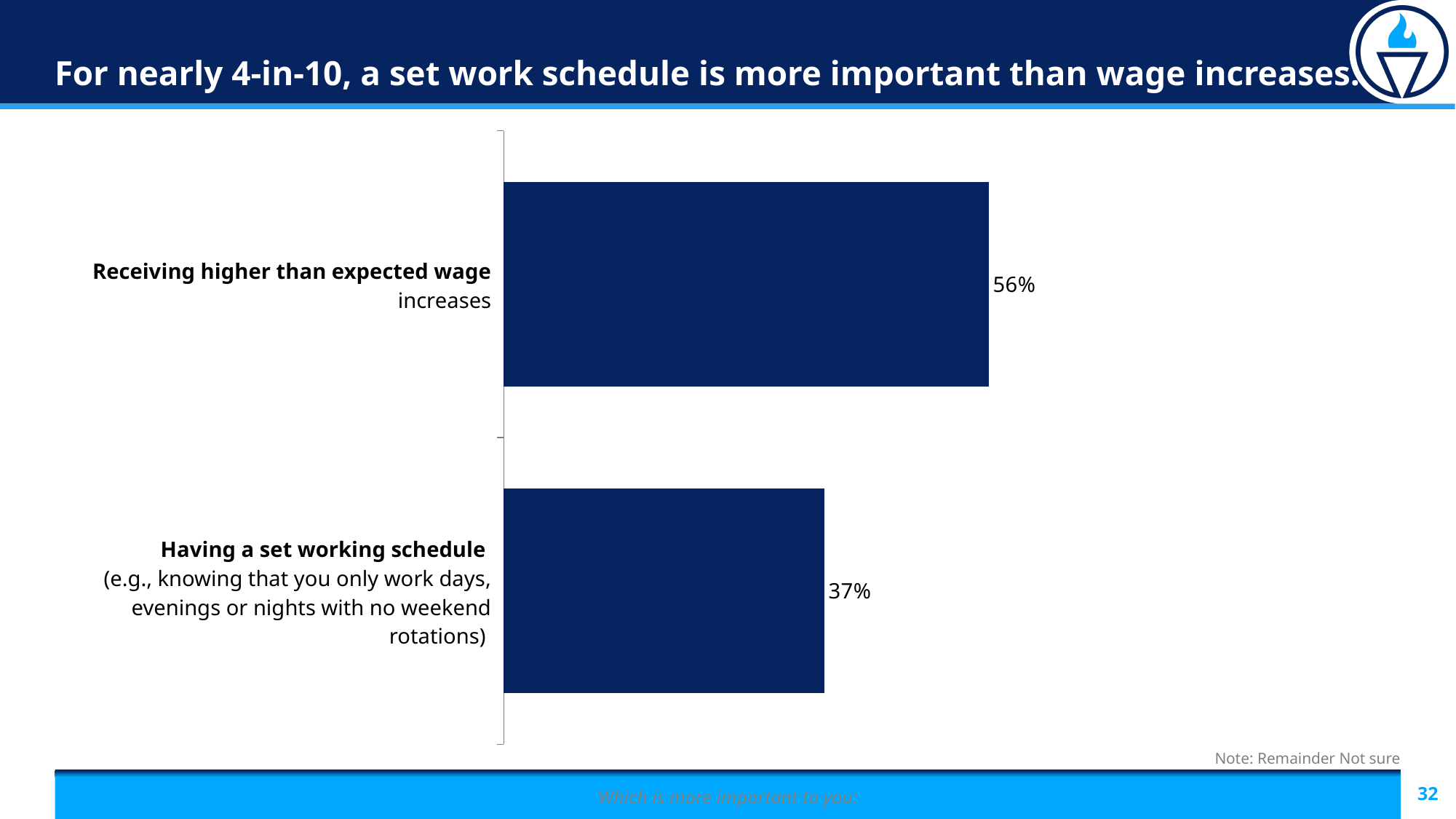
What percentage of respondents said receiving higher than expected wage increases is more important? 56% How many categories are shown in the chart? 2 What percentage of respondents said having a set working schedule is more important? 37% What is the title of the slide? For nearly 4-in-10, a set work schedule is more important than wage increases. What is the combined percentage of the two options shown? 93% Which option has the lower percentage? Having a set working schedule According to the note on the slide, what does the remainder of respondents represent? Not sure What kind of chart is shown on the slide? Bar chart Is the value for having a set working schedule greater or less than the value for receiving higher than expected wage increases? less Which option has the higher percentage? Receiving higher than expected wage increases What is the difference in percentage points between the wage increases option and the set working schedule option? 19